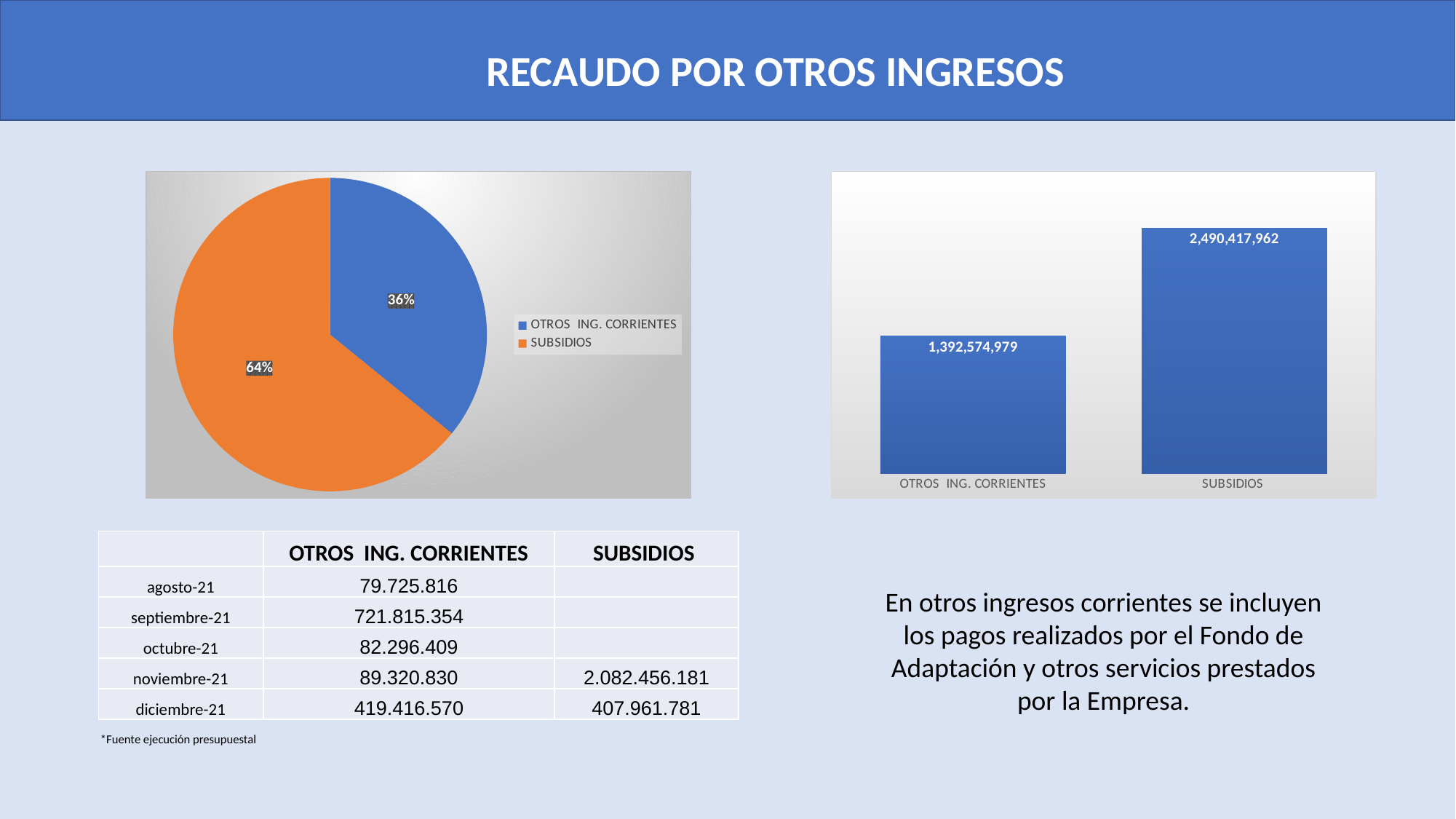
What type of chart is the chart on the right of the slide? bar chart In the pie chart on the left, which category has the largest slice? SUBSIDIOS In the pie chart on the left, what share does SUBSIDIOS have? 64% What type of chart is the chart on the left of the slide? pie chart How many entries does the legend of the pie chart on the left list? 2 In the pie chart on the left, what share does OTROS ING. CORRIENTES have? 36% In the bar chart on the right, what is the value for SUBSIDIOS? 2,490,417,962 In the bar chart on the right, what is the difference between the SUBSIDIOS value and the OTROS ING. CORRIENTES value? 1,097,842,983 How many bars are shown in the bar chart on the right? 2 In the bar chart on the right, what is the value for OTROS ING. CORRIENTES? 1,392,574,979 In the pie chart on the left, what colour is the SUBSIDIOS slice? orange In the bar chart on the right, which category has the lowest value? OTROS ING. CORRIENTES